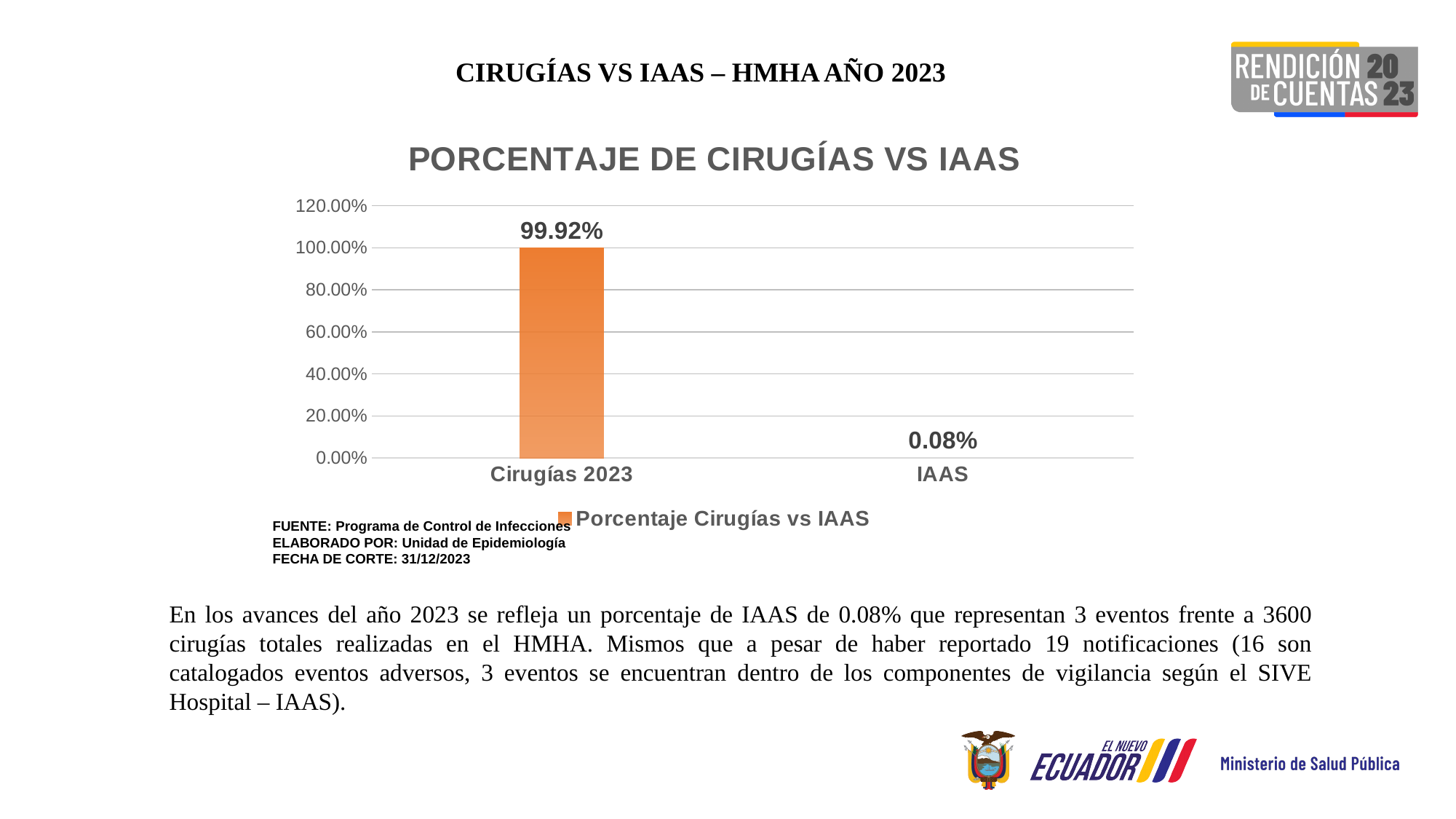
Is the value for IAAS greater or less than 20.00%? less What is the value for IAAS? 0.08% Which category has the lowest value? IAAS What kind of chart is shown? bar chart What is the title of the chart? PORCENTAJE DE CIRUGÍAS VS IAAS Which category has the highest value? Cirugías 2023 What is the difference between the values for Cirugías 2023 and IAAS? 99.84% How many series does the legend list? 1 Which is larger, the value for Cirugías 2023 or the value for IAAS? Cirugías 2023 Is the value for Cirugías 2023 greater or less than 80.00%? greater What is the value for Cirugías 2023? 99.92% How many categories are shown on the x axis? 2